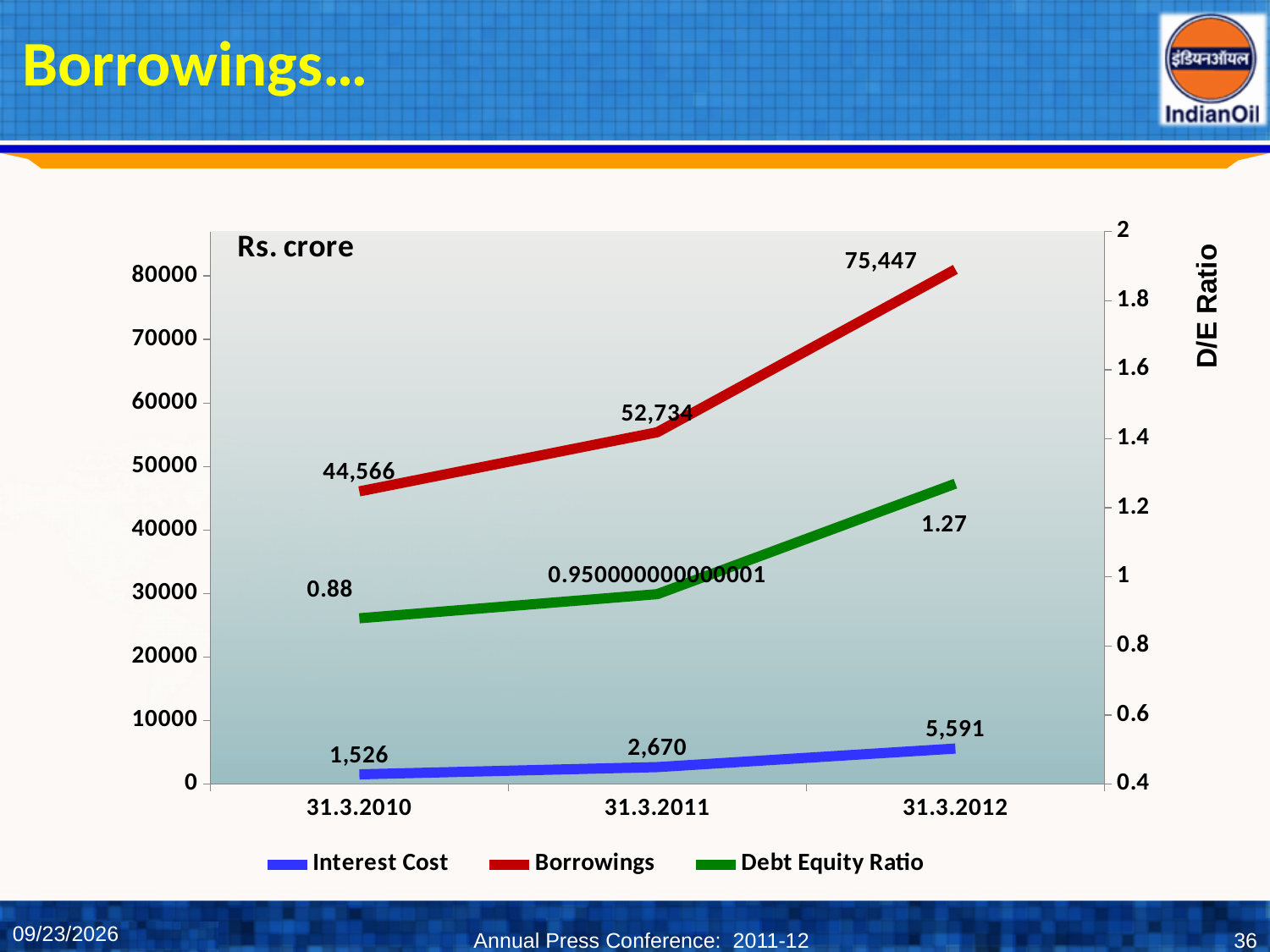
Which was larger on 31.3.2011: Borrowings or Interest Cost? Borrowings What kind of chart is shown on the slide? Line chart On which date was the Interest Cost highest? 31.3.2012 How many series does the legend list? 3 By how much did Borrowings increase from 31.3.2010 to 31.3.2012? 30,881 Do Borrowings rise or fall from 31.3.2010 to 31.3.2012? Rise What was the Interest Cost on 31.3.2010? 1,526 On which date was Borrowings lowest? 31.3.2010 What was the Debt Equity Ratio on 31.3.2012? 1.27 What is the difference in Interest Cost between 31.3.2012 and 31.3.2010? 4,065 What was the value of Borrowings on 31.3.2012? 75,447 What was the value of Borrowings on 31.3.2011? 52,734